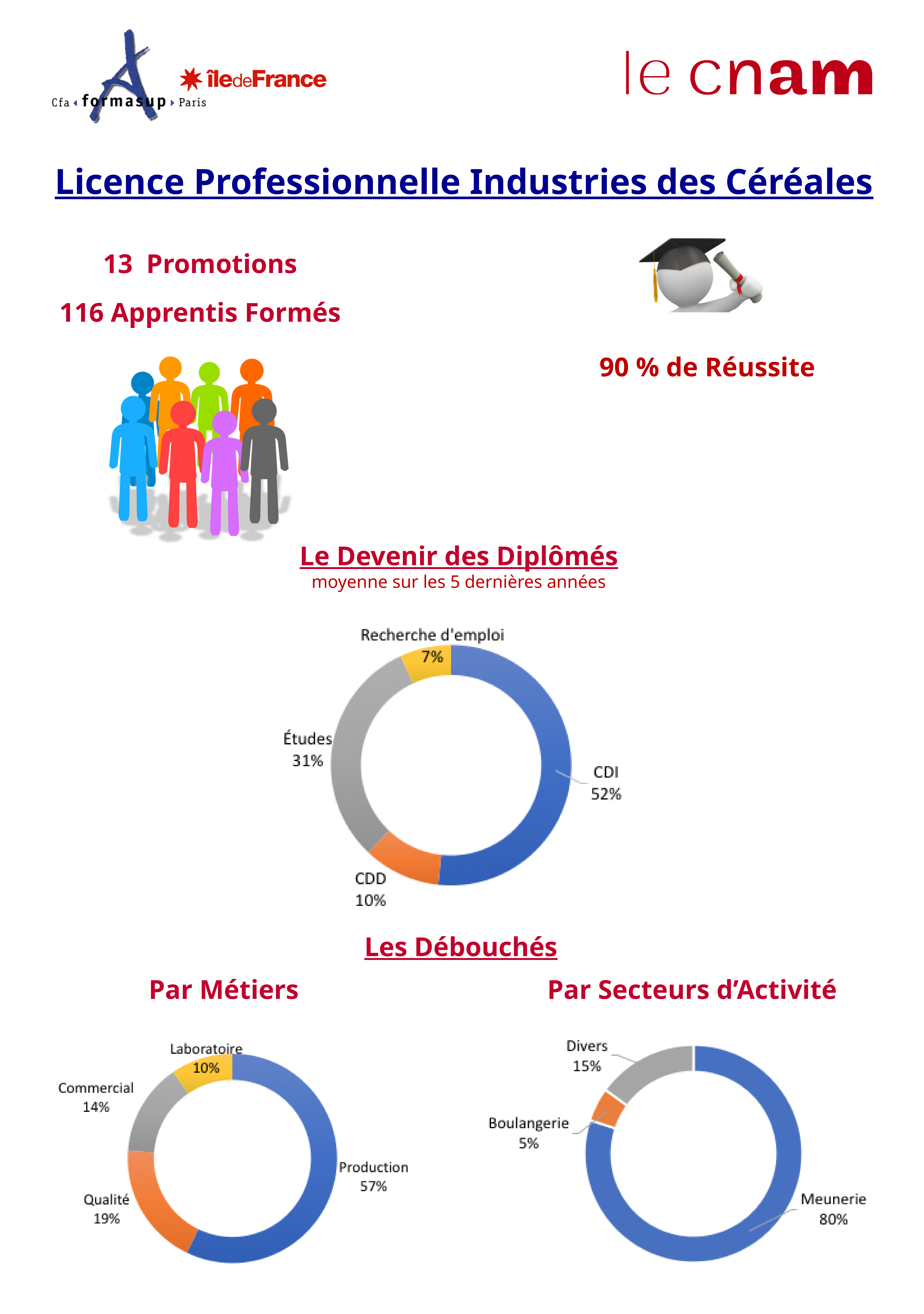
In the 'Le Devenir des Diplômés' chart, what is the difference between the CDI share and the CDD share? 42% In the 'Le Devenir des Diplômés' chart, what share is labelled for Études? 31% In the 'Par Métiers' chart, which category has the largest share? Production What kind of chart is used for 'Le Devenir des Diplômés'? Doughnut (pie) chart In the 'Le Devenir des Diplômés' chart, how many categories are shown? 4 In the 'Par Secteurs d'Activité' chart, what is the difference between the Divers share and the Boulangerie share? 10% In the 'Par Métiers' chart, which is larger, Commercial or Laboratoire? Commercial In the 'Le Devenir des Diplômés' chart, which category has the smallest share? Recherche d'emploi In the 'Par Secteurs d'Activité' chart, which category has the smallest share? Boulangerie In the 'Par Métiers' chart, what share is labelled for Qualité? 19% In the 'Le Devenir des Diplômés' chart, what share is labelled for CDI? 52% In the 'Par Secteurs d'Activité' chart, what share is labelled for Meunerie? 80%